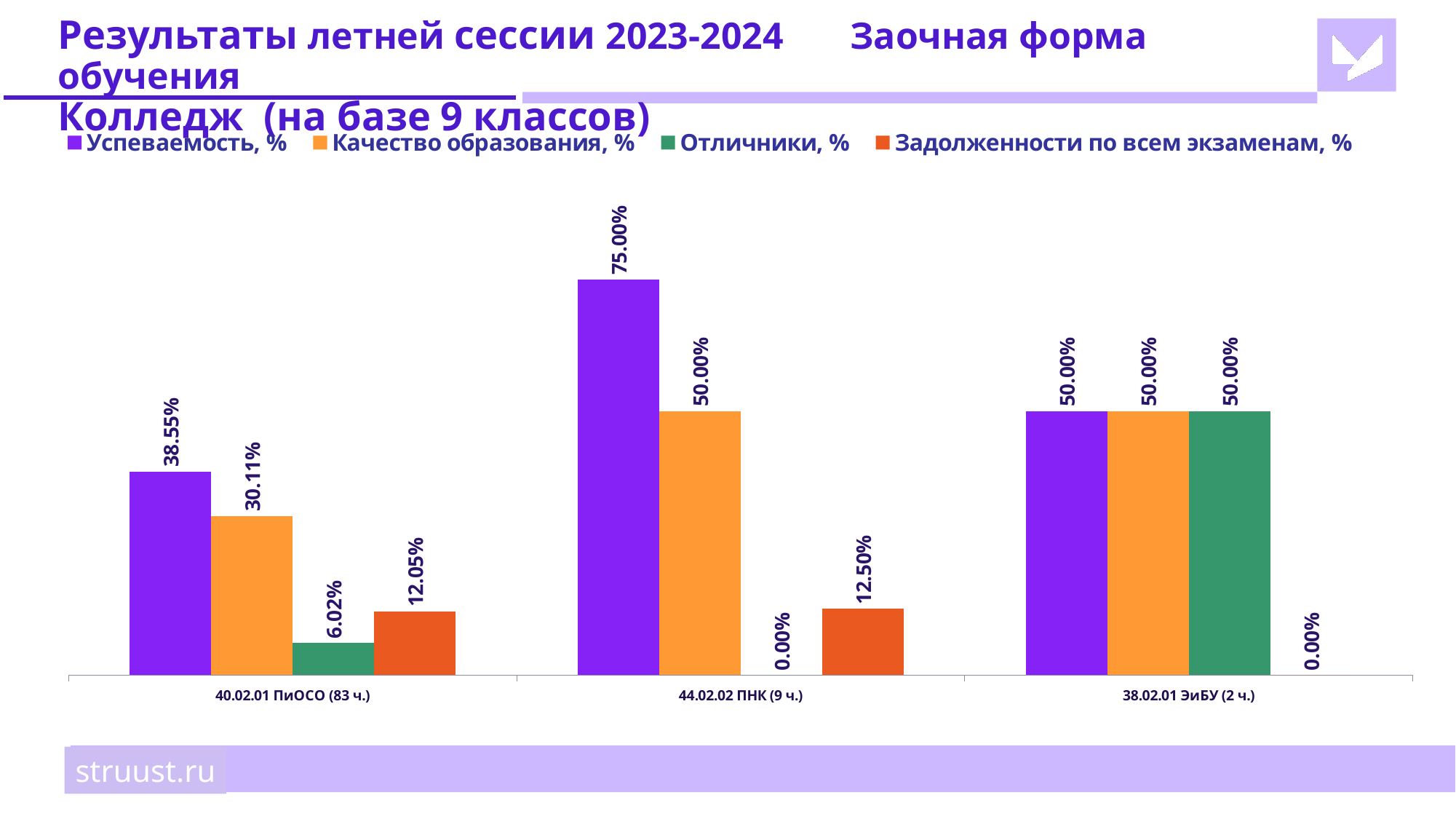
Which colour represents Отличники, % in the legend? Green Which category has the lowest value of Отличники, %? 44.02.02 ПНК (9 ч.) What is the value of Качество образования, % for 44.02.02 ПНК (9 ч.)? 50.00% How many categories are shown on the x axis? 3 How many series does the legend list? 4 What is the value of Успеваемость, % for 40.02.01 ПиОСО (83 ч.)? 38.55% What is the difference between Успеваемость, % and Качество образования, % for 44.02.02 ПНК (9 ч.)? 25.00% What is the value of Отличники, % for 40.02.01 ПиОСО (83 ч.)? 6.02% Which category has the highest value of Успеваемость, %? 44.02.02 ПНК (9 ч.) Which is larger: Задолженности по всем экзаменам, % for 40.02.01 ПиОСО (83 ч.) or for 44.02.02 ПНК (9 ч.)? 44.02.02 ПНК (9 ч.) What kind of chart is shown on the slide? Bar chart What is the value of Задолженности по всем экзаменам, % for 38.02.01 ЭиБУ (2 ч.)? 0.00%